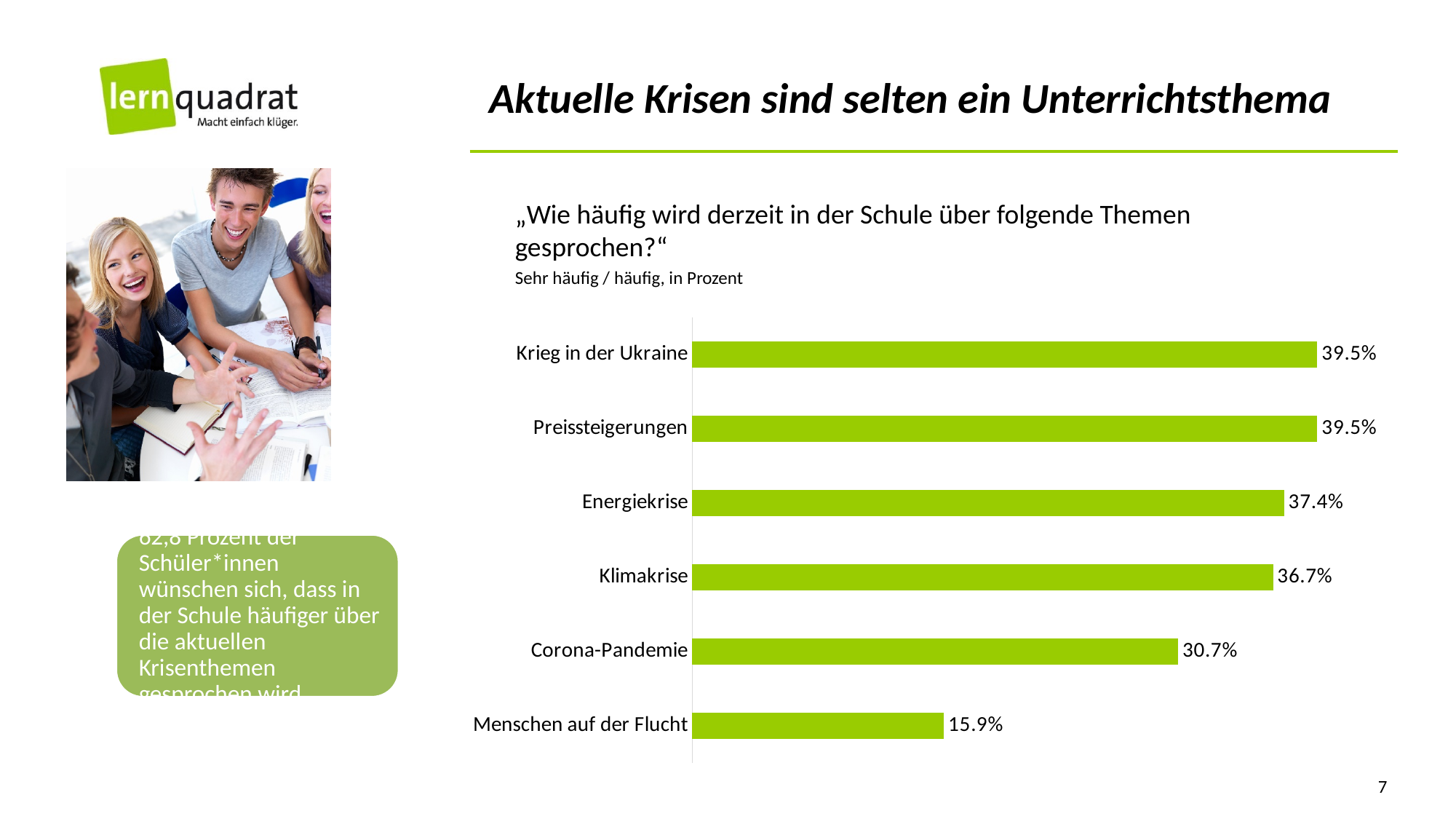
What is the title of the slide containing the chart? Aktuelle Krisen sind selten ein Unterrichtsthema How many categories are shown in the chart? 6 What is the difference between the values for Krieg in der Ukraine and Menschen auf der Flucht? 23.6% Which is larger, the value for Klimakrise or the value for Corona-Pandemie? Klimakrise What value is shown for Corona-Pandemie? 30.7% What is the highest value shown in the chart? 39.5% What value is shown for Energiekrise? 37.4% What kind of chart is shown on the slide? Bar chart Which category has the lowest value? Menschen auf der Flucht What value is shown for Klimakrise? 36.7% What is the difference between the values for Energiekrise and Corona-Pandemie? 6.7% What value is shown for Menschen auf der Flucht? 15.9%